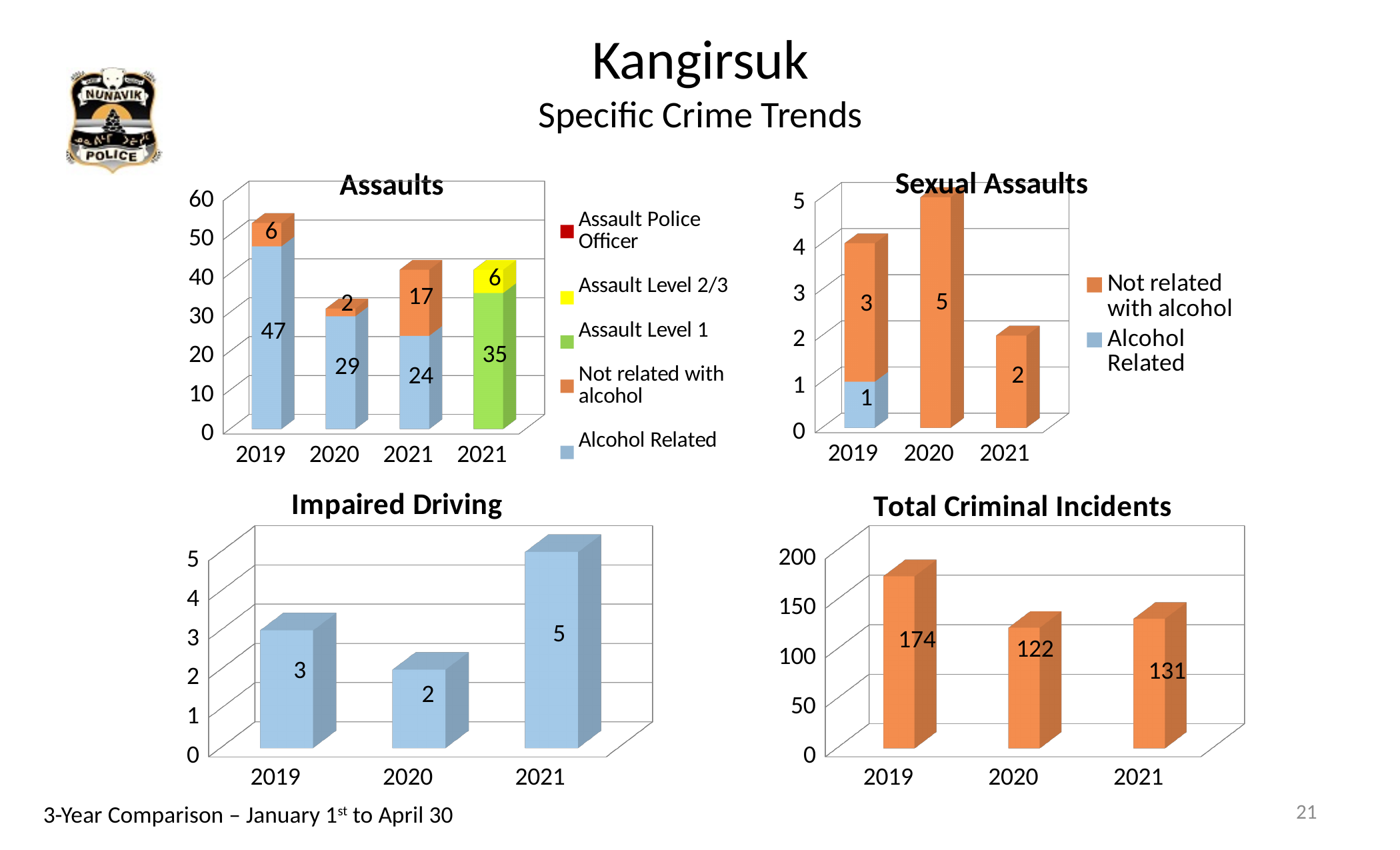
In the Total Criminal Incidents chart, what is the difference between the 2019 and 2021 values? 43 What kind of chart is the Impaired Driving chart? bar chart In the Assaults chart, what is the Not related with alcohol value for 2021? 17 In the Assaults chart, what is the Alcohol Related value for 2019? 47 In the Total Criminal Incidents chart, is the value for 2020 greater or less than 150? less In the Total Criminal Incidents chart, which year has the lowest value? 2020 In the Impaired Driving chart, which year has the highest value? 2021 In the Impaired Driving chart, what is the difference between the 2021 and 2020 values? 3 In the Sexual Assaults chart, what is the total of the stacked bar for 2019? 4 How many series does the legend of the Assaults chart list? 5 In the Assaults chart, what is the total of the stacked bar for 2020? 31 In the Sexual Assaults chart, what is the Not related with alcohol value for 2020? 5